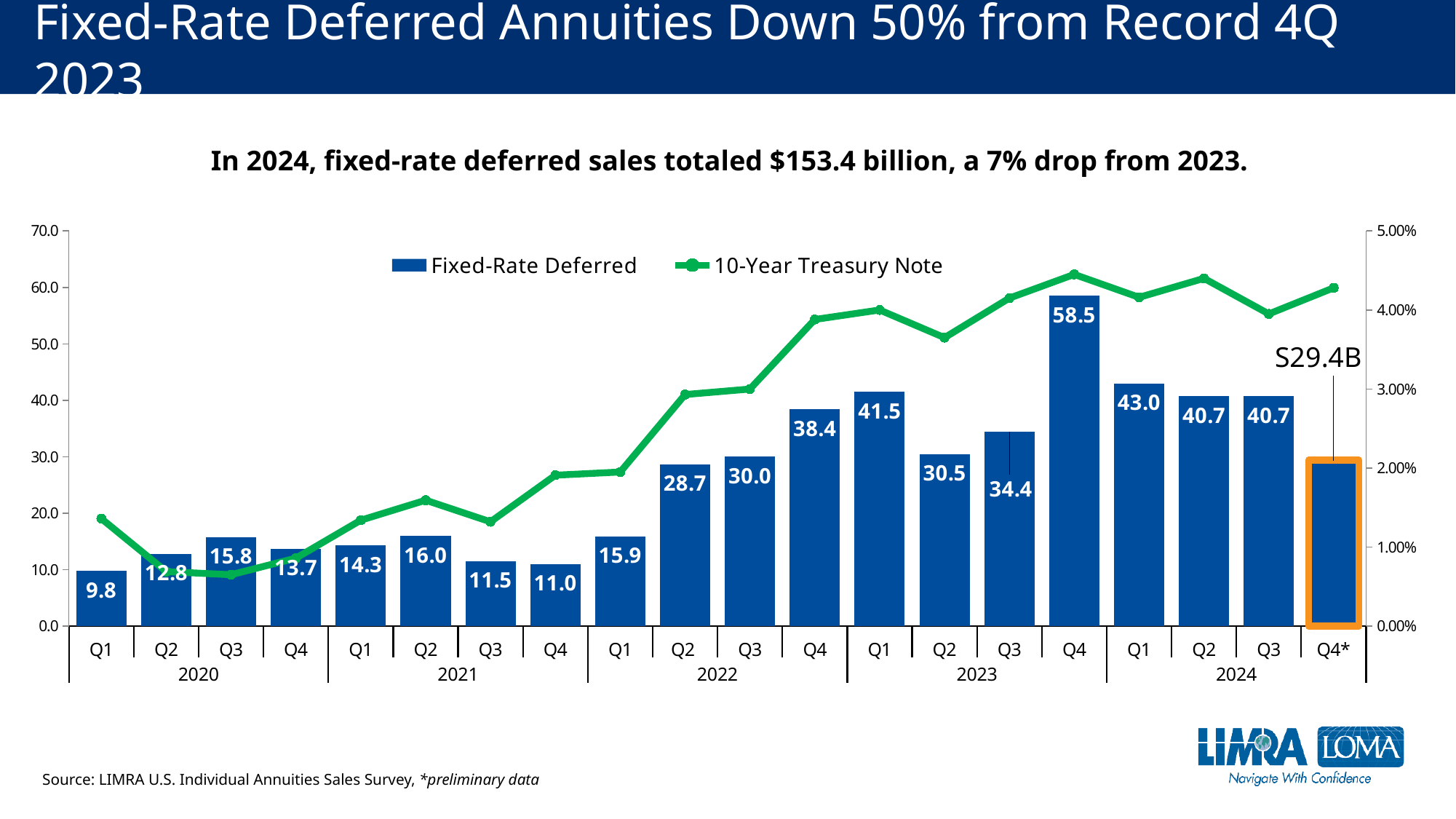
Is the 10-Year Treasury Note value for Q3 2020 greater or less than 1.00%? less How many quarterly bars are plotted for Fixed-Rate Deferred? 20 Do the Fixed-Rate Deferred values rise or fall from Q1 to Q4 of 2022? rise Which quarter has the lowest Fixed-Rate Deferred value? Q1 2020 What is the Fixed-Rate Deferred value for Q4 2023? 58.5 Is the 10-Year Treasury Note value for Q4 2023 greater or less than 4.00%? greater What is the difference between the Fixed-Rate Deferred values for Q1 2023 and Q2 2023? 11.0 Which quarter has the highest Fixed-Rate Deferred value? Q4 2023 What value is labeled on the Fixed-Rate Deferred bar for Q4* 2024? $29.4B What is the difference between the Fixed-Rate Deferred values for Q4 2023 and Q4* 2024? 29.1 How many series does the legend list? 2 Which has the larger Fixed-Rate Deferred value, Q1 2024 or Q2 2024? Q1 2024